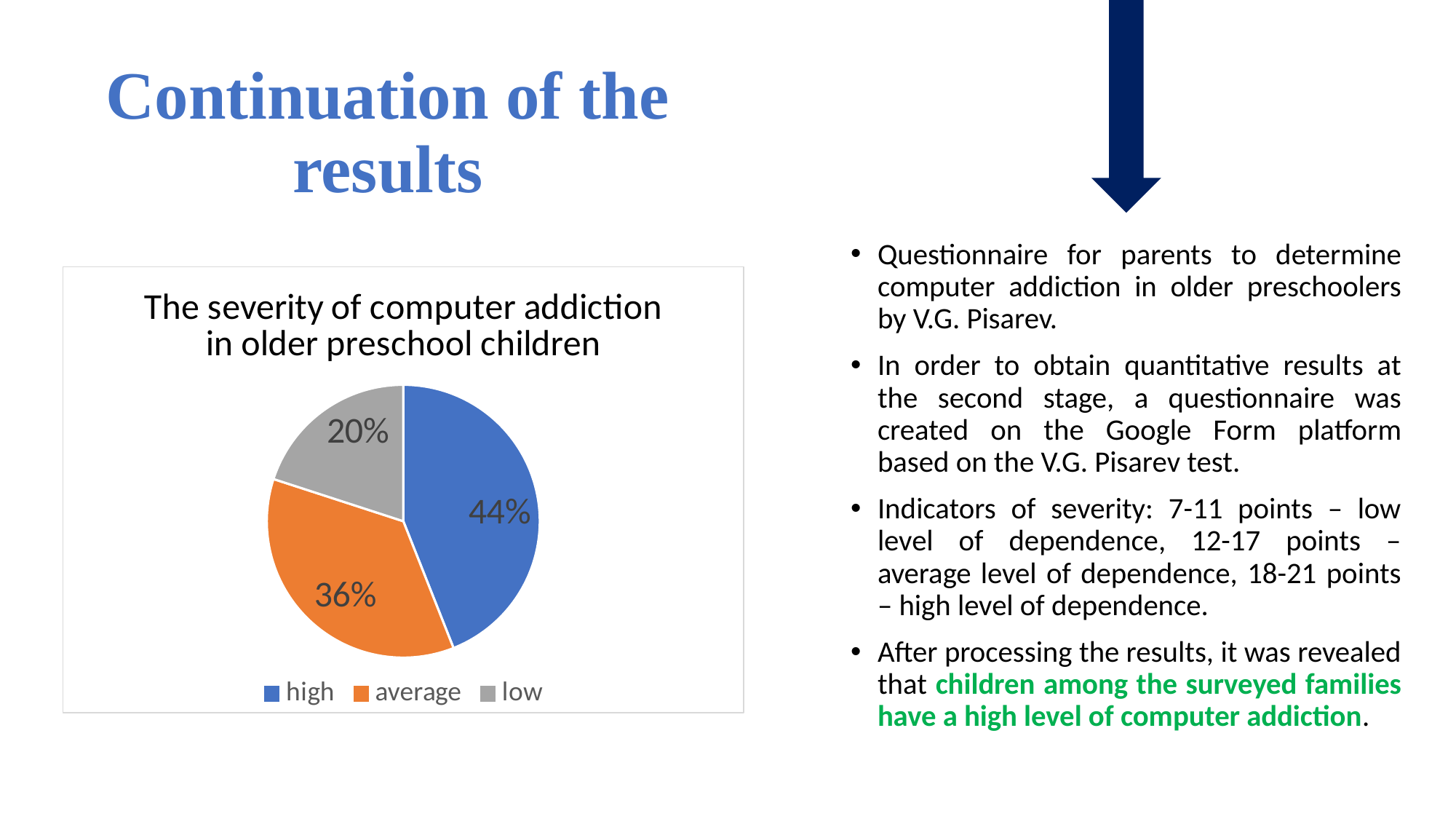
Which category has the smallest share of the pie? low What is the difference in percentage points between the "high" and "average" slices? 8 What type of chart is shown on the slide? pie chart Which slice is larger, "average" or "low"? average What percentage of the pie is labelled "average"? 36% What percentage of the pie is labelled "high"? 44% What is the difference in percentage points between the "high" and "low" slices? 24 How many categories does the pie chart show? 3 Which category has the largest share of the pie? high What percentage of the pie is labelled "low"? 20% What colour is the "average" slice in the pie chart? orange What is the title of the chart? The severity of computer addiction in older preschool children